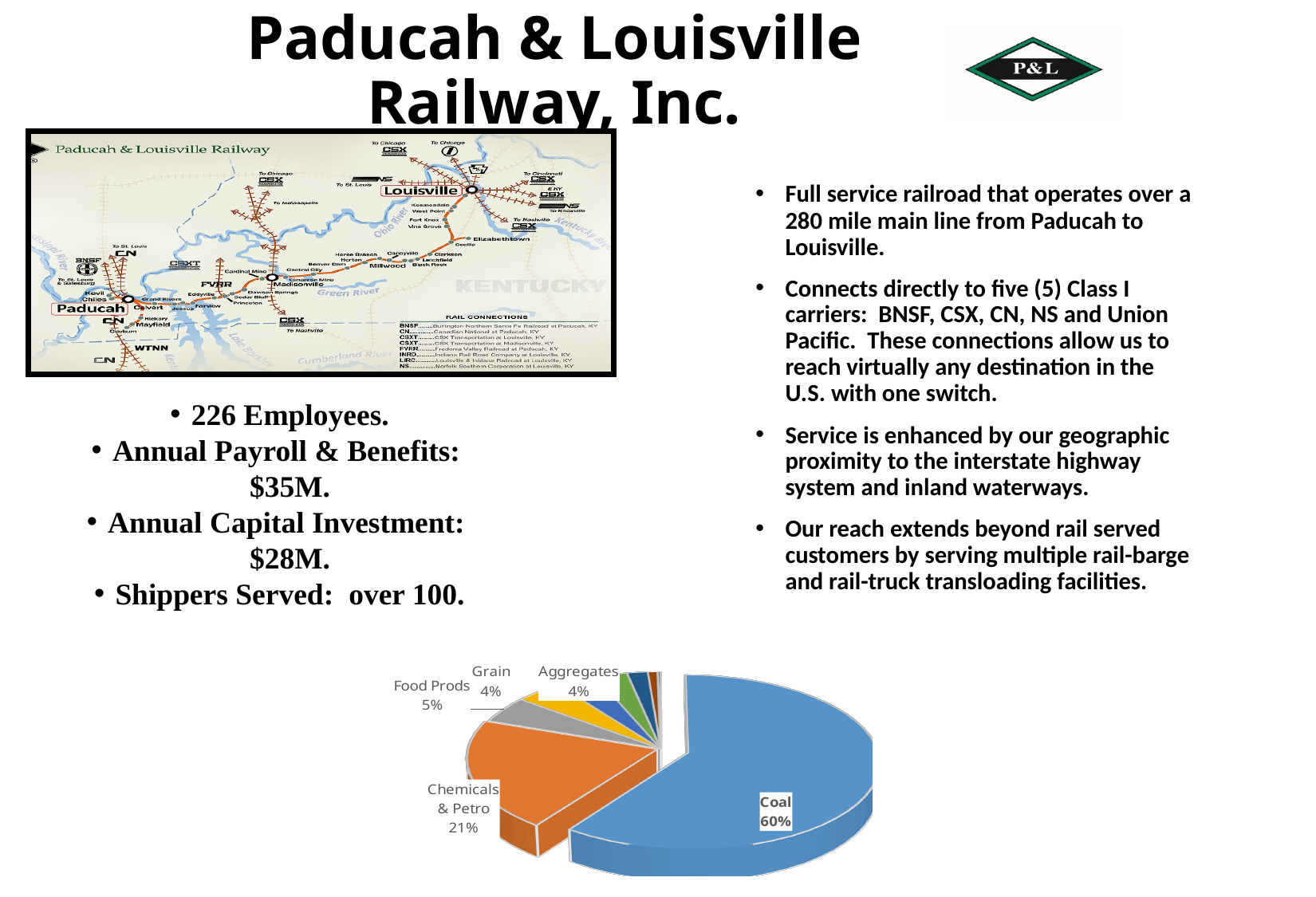
What type of chart is shown at the bottom of the slide? Pie chart What share of the pie chart is Food Prods? 5% What percentage does Grain account for in the pie chart? 4% What is the difference in percentage points between Coal and Chemicals & Petro? 39% Which is larger in the pie chart, Chemicals & Petro or Food Prods? Chemicals & Petro What colour is the Coal slice in the pie chart? Blue What is the difference in percentage points between Chemicals & Petro and Food Prods? 16% What percentage of the pie chart does Coal represent? 60% What colour is the Chemicals & Petro slice in the pie chart? Orange Which category has the largest slice in the pie chart? Coal What percentage does Aggregates account for in the pie chart? 4% What percentage of the pie chart is Chemicals & Petro? 21%